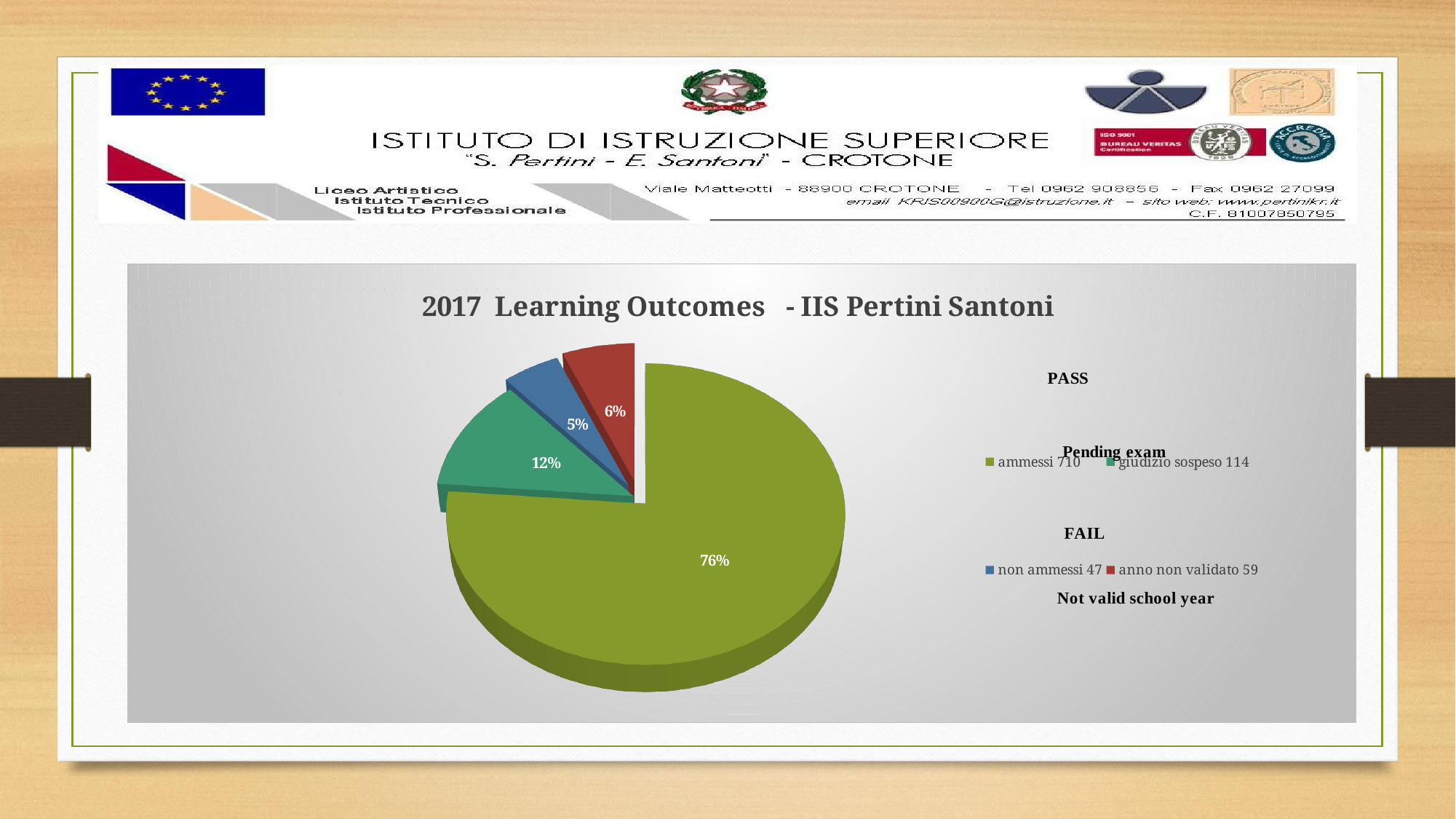
How many slices does the pie chart have? 4 Which slice of the pie is the smallest? non ammessi 47 What is the title of the chart? 2017 Learning Outcomes - IIS Pertini Santoni What kind of chart is shown on the slide? pie chart What share of the pie does the 'ammessi 710' slice represent? 76% What share of the pie does the 'anno non validato 59' slice represent? 6% Which slice is larger: 'giudizio sospeso 114' or 'anno non validato 59'? giudizio sospeso 114 Which slice of the pie is the largest? ammessi 710 How many entries does the legend list? 4 What is the difference in percentage points between the 'ammessi 710' slice and the 'giudizio sospeso 114' slice? 64 What share of the pie does the 'giudizio sospeso 114' slice represent? 12%